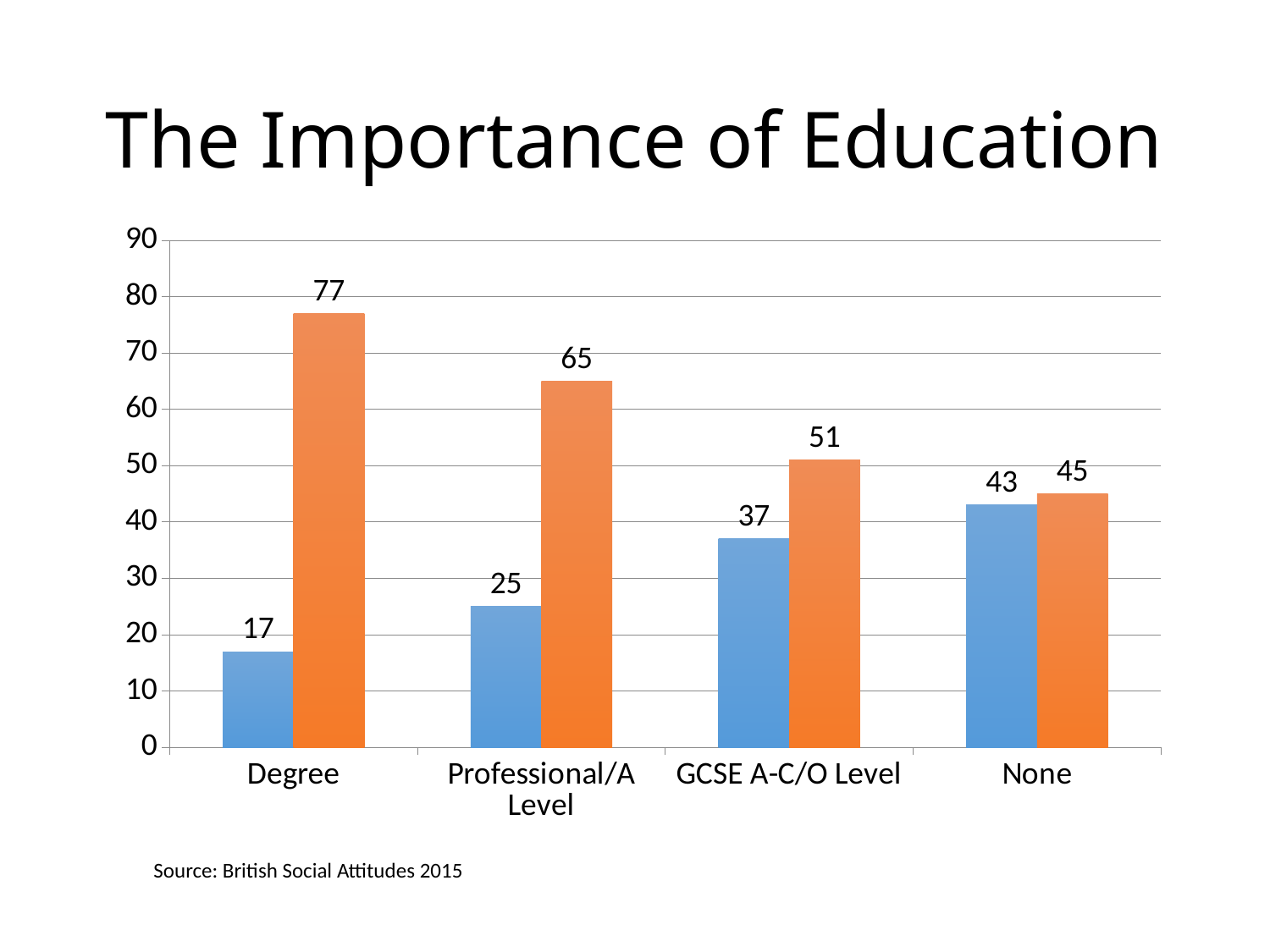
What is the difference between the orange and blue bars for Degree? 60 What is the difference between the orange and blue bars for None? 2 Which is larger for GCSE A-C/O Level, the blue bar or the orange bar? the orange bar Which category has the highest orange bar? Degree What is the value of the orange bar for Professional/A Level? 65 What kind of chart is shown on the slide? bar chart Do the orange bars rise or fall from Degree to None? fall What is the value of the blue bar for None? 43 Which category has the lowest blue bar? Degree What is the value of the blue bar for Degree? 17 What is the title of the slide containing the chart? The Importance of Education How many categories are shown on the x axis? 4